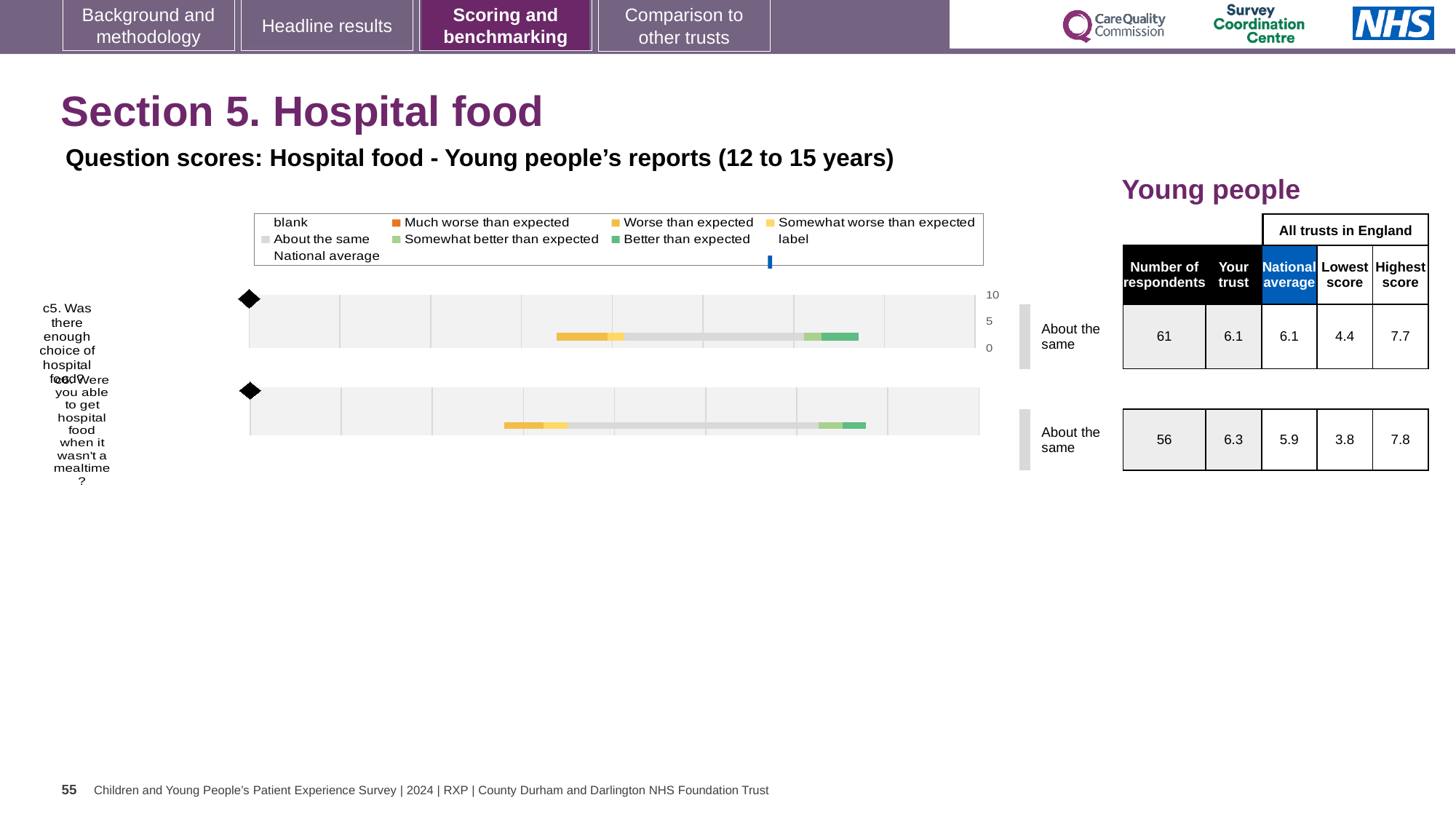
According to the table beside the chart, what is the 'Your trust' score for c6 (Were you able to get hospital food when it wasn't a mealtime?)? 6.3 What benchmark label is given for both c5 and c6 next to the chart? About the same What is the number of respondents for c6 in the table beside the chart? 56 What is the difference between the highest score and the lowest score for c6 in the table? 4.0 Which legend entry is shown in dark green? Better than expected What kind of chart is shown on the slide? Bar chart What is the highest value shown on the chart's axis? 10 According to the table beside the chart, what is the 'Your trust' score for c5 (Was there enough choice of hospital food?)? 6.1 How many questions (categories) are plotted in the chart? 2 What is the national average for c5 in the table beside the chart? 6.1 Which question has the higher 'Your trust' score, c5 or c6? c6 How many entries does the chart legend list? 9